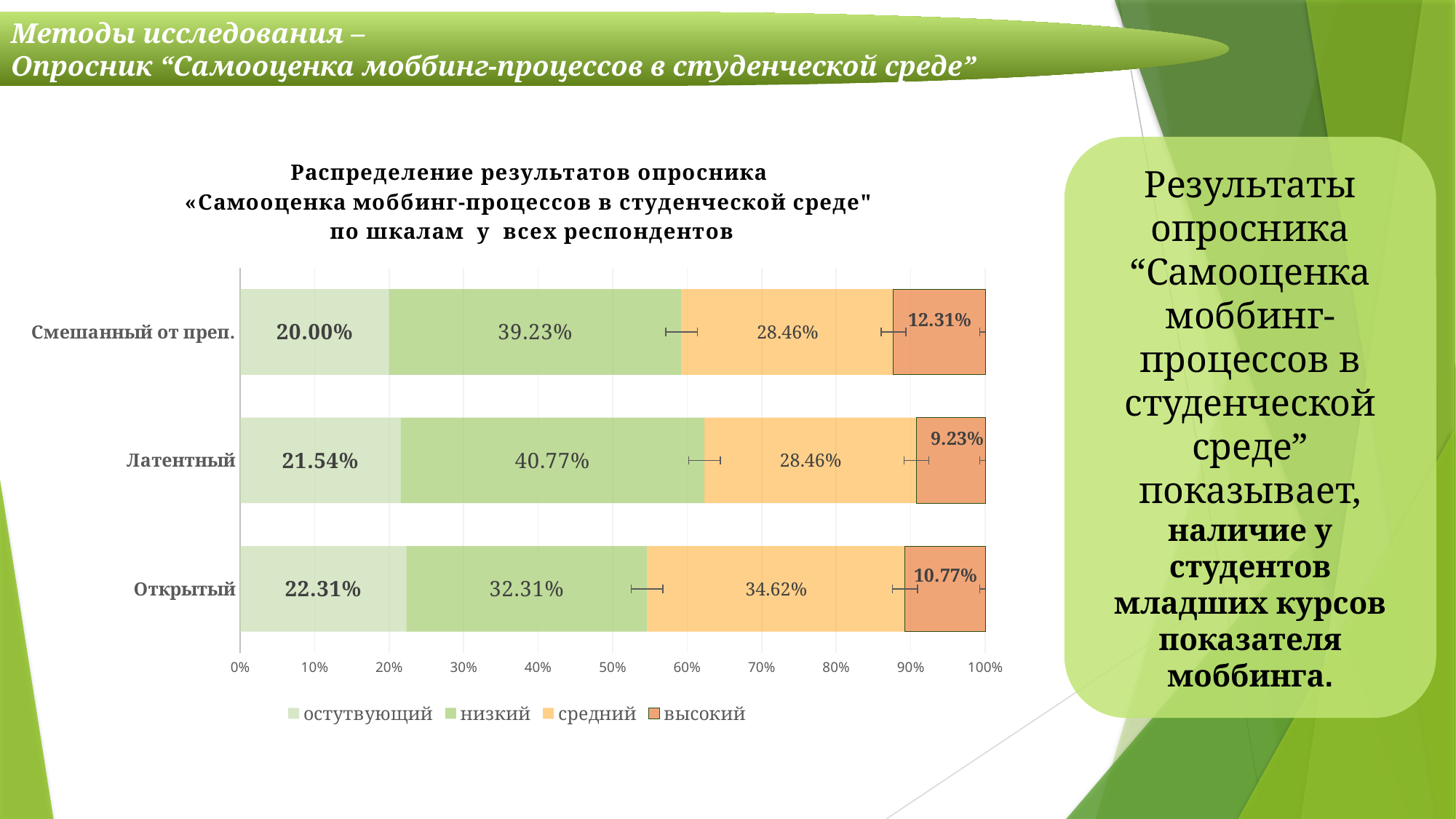
Which legend entry is shown in orange? высокий What is the value of the 'низкий' segment for 'Латентный'? 40.77% Which is larger: the 'остутвующий' value for 'Латентный' or for 'Смешанный от преп.'? Латентный What is the difference between the 'средний' values for 'Открытый' and 'Латентный'? 6.16% Which category has the highest 'высокий' value? Смешанный от преп. How many series does the legend list? 4 What is the value of the 'средний' segment for 'Открытый'? 34.62% How many categories (scales) are plotted on the chart? 3 What is the value of the 'остутвующий' segment for 'Открытый'? 22.31% Which category has the lowest 'низкий' value? Открытый What kind of chart is shown on the slide? stacked bar chart What is the value of the 'высокий' segment for 'Смешанный от преп.'? 12.31%